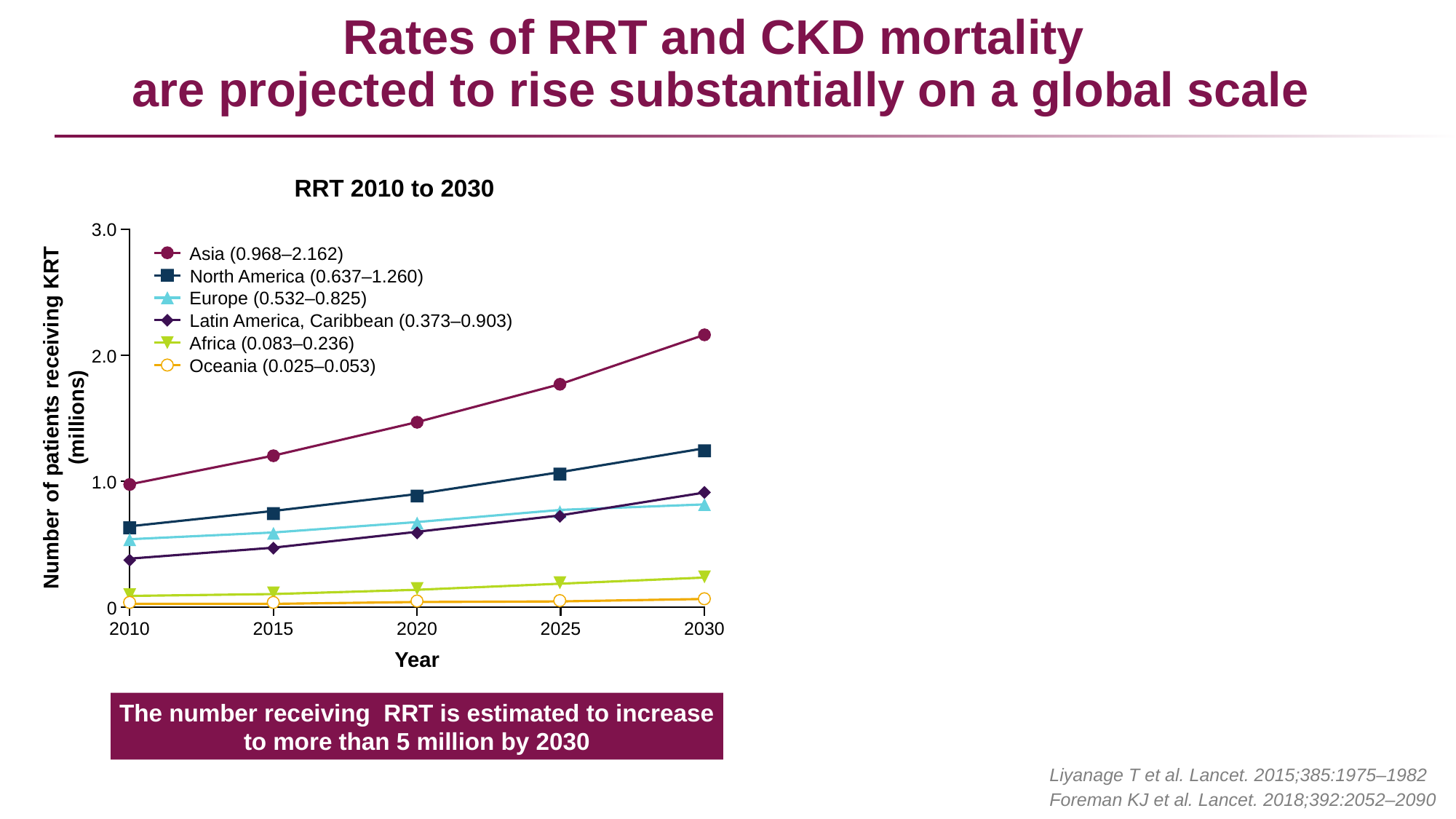
In 2025, which is larger: the value for Asia or the value for North America? Asia What is the title of the chart? RRT 2010 to 2030 How many series does the legend of the RRT 2010 to 2030 chart list? 6 Which region has the highest number of patients receiving KRT in 2030? Asia Does the number of patients receiving KRT in Asia rise or fall from 2010 to 2030? Rise Is the value for Asia in 2030 greater or less than 2.0? greater How many years are marked on the x axis of the chart? 5 What kind of chart is shown on the slide? Line chart What range of values does the legend give for Europe? 0.532–0.825 Which region has the lowest number of patients receiving KRT across the chart? Oceania Is the value for Latin America, Caribbean in 2010 greater or less than 0.5? less Is the value for North America in 2030 greater or less than 1.0? greater